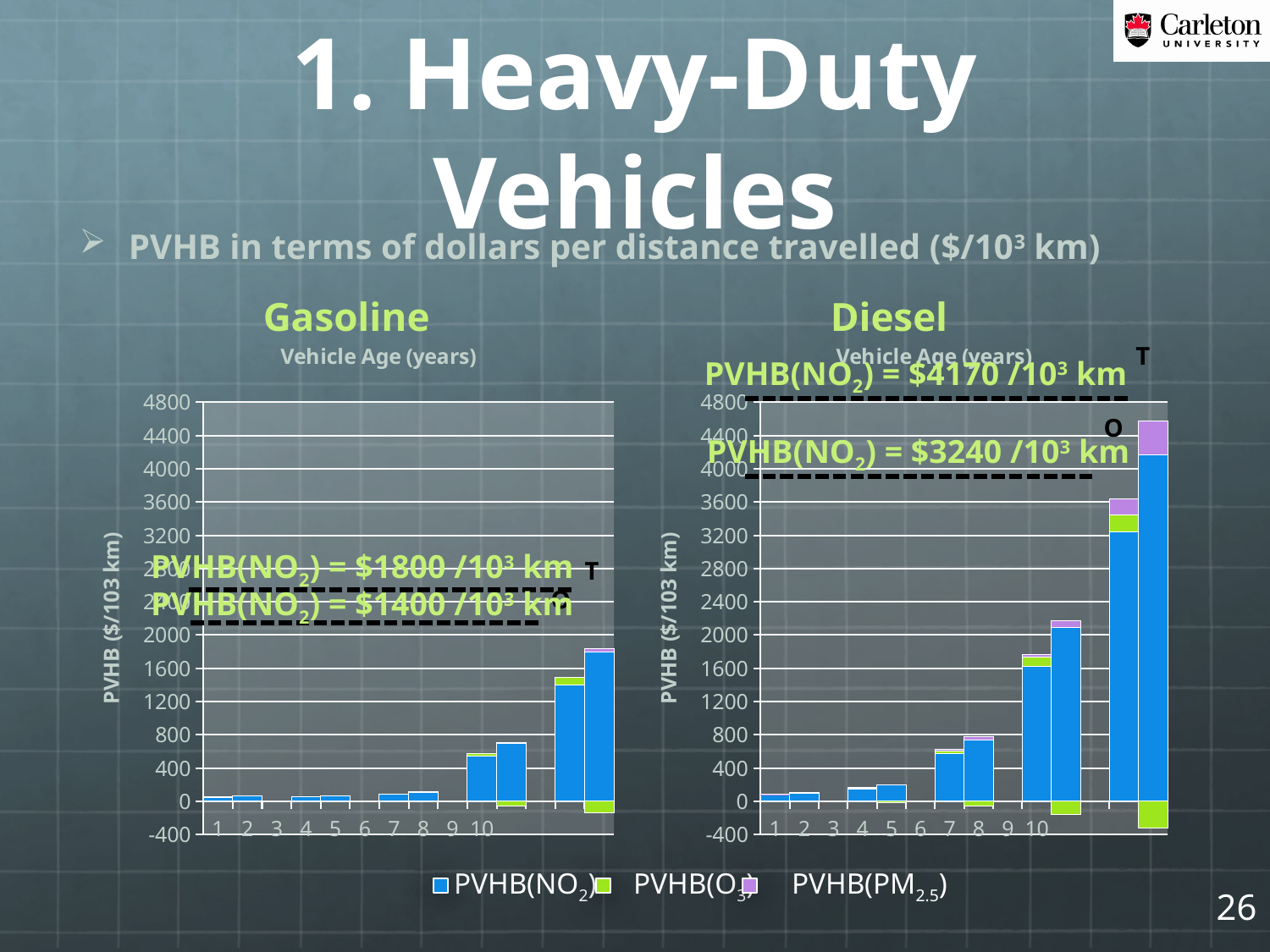
On the Gasoline chart, do the PVHB(NO2) values generally rise or fall as vehicle age increases? rise What kind of chart is the Gasoline chart? bar chart On the Diesel chart, is the PVHB(NO2) value of the tallest bar greater or less than 4000? greater On the Gasoline chart, what is the difference between the annotated PVHB(NO2) values for T and O? $400 /10³ km What is the title of the y axis on the Diesel chart? PVHB ($/103 km) On the Diesel chart, what PVHB(NO2) value is annotated for O? $3240 /10³ km On the Gasoline chart, what PVHB(NO2) value is annotated for O? $1400 /10³ km Which chart has the larger annotated PVHB(NO2) value for T, Gasoline or Diesel? Diesel On the Diesel chart, what is the difference between the annotated PVHB(NO2) values for T and O? $930 /10³ km On the Gasoline chart, what PVHB(NO2) value is annotated for T? $1800 /10³ km How many series does the legend list? 3 On the Diesel chart, what PVHB(NO2) value is annotated for T? $4170 /10³ km